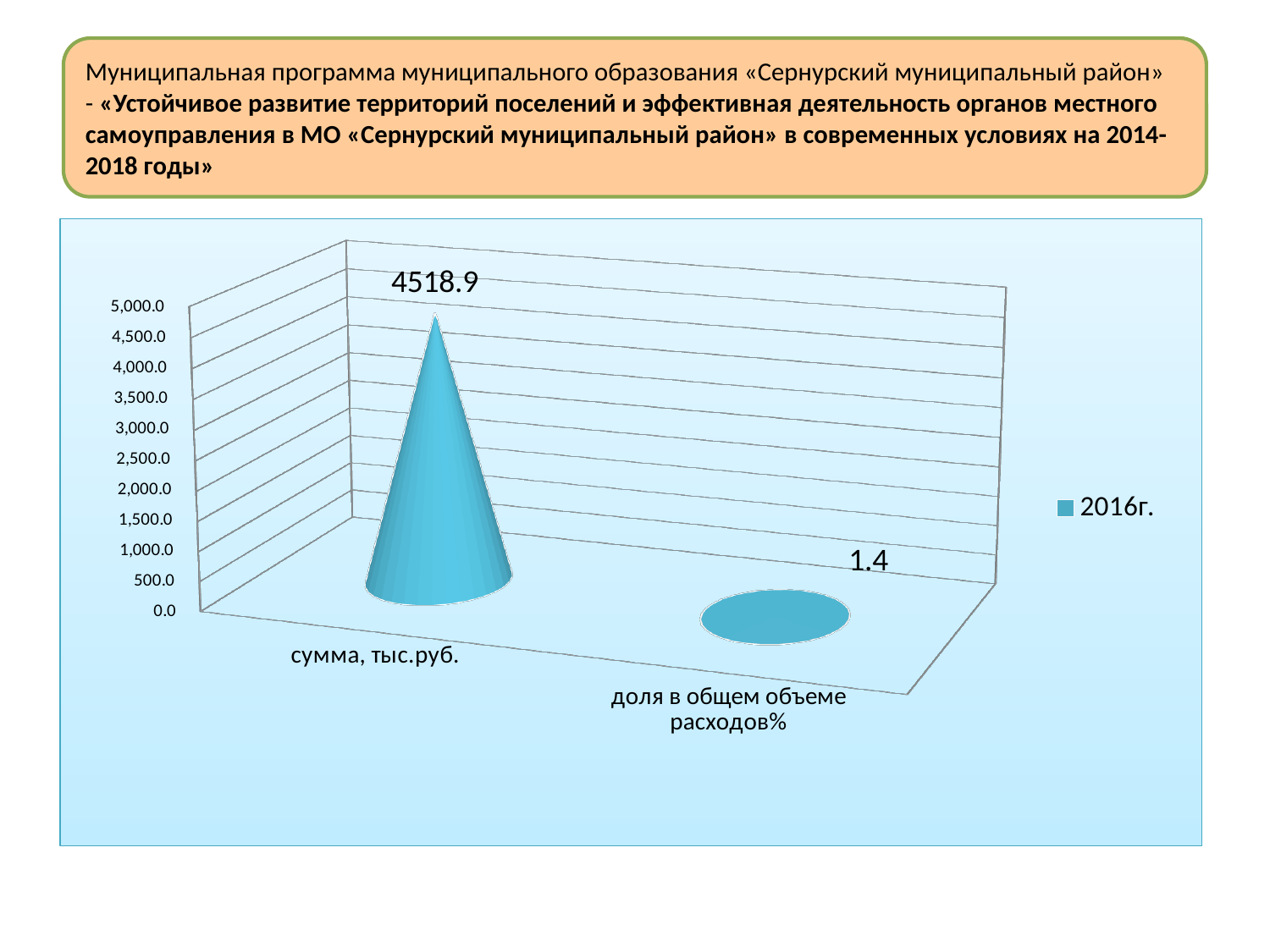
Is the value for "доля в общем объеме расходов%" greater or less than 500.0? less Which category has the lowest value? доля в общем объеме расходов% How many series does the legend list? 1 What kind of chart is shown on the slide? bar chart What is the value for "сумма, тыс.руб."? 4518.9 Is the value for "сумма, тыс.руб." greater or less than 4,000.0? greater How many categories are shown on the x axis of the chart? 2 What series name is shown in the chart legend? 2016г. What is the value for "доля в общем объеме расходов%"? 1.4 Which is larger: the value for "сумма, тыс.руб." or the value for "доля в общем объеме расходов%"? сумма, тыс.руб. What is the difference between the value for "сумма, тыс.руб." and the value for "доля в общем объеме расходов%"? 4517.5 Which category has the highest value? сумма, тыс.руб.